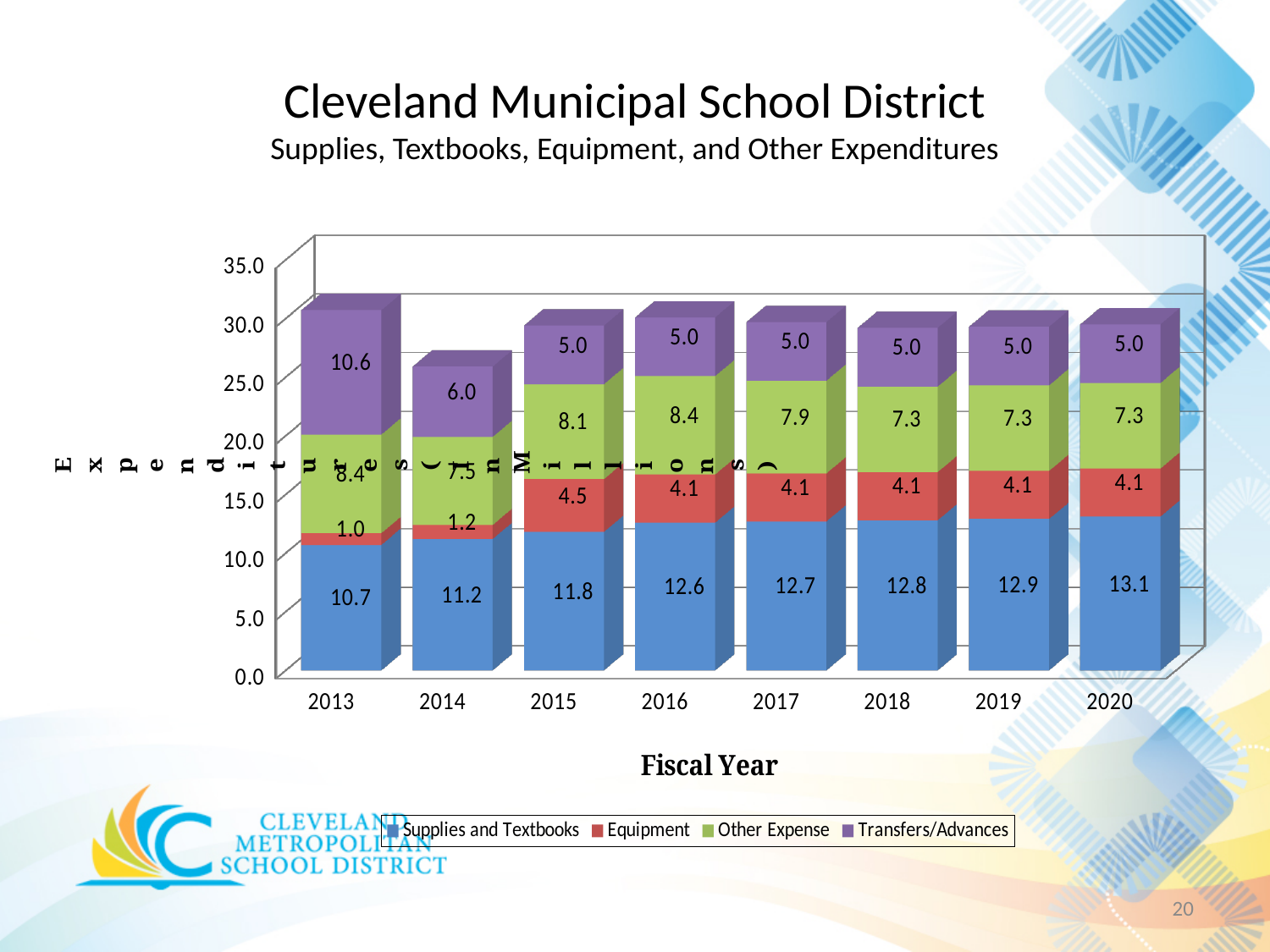
What is the value for Equipment in fiscal year 2015? 4.5 What is the difference between the Supplies and Textbooks values for 2020 and 2013? 2.4 What is the value for Transfers/Advances in fiscal year 2013? 10.6 What is the value for Supplies and Textbooks in fiscal year 2020? 13.1 In which fiscal year is the Supplies and Textbooks value the highest? 2020 What kind of chart is shown on the slide? Stacked bar chart How many series does the legend list? 4 Which fiscal year has the larger Other Expense value, 2016 or 2017? 2016 In which fiscal year is the Transfers/Advances value the highest? 2013 What is the total of the stacked bar for fiscal year 2016? 30.1 In which fiscal year is the Supplies and Textbooks value the lowest? 2013 How many fiscal years are shown on the x axis? 8